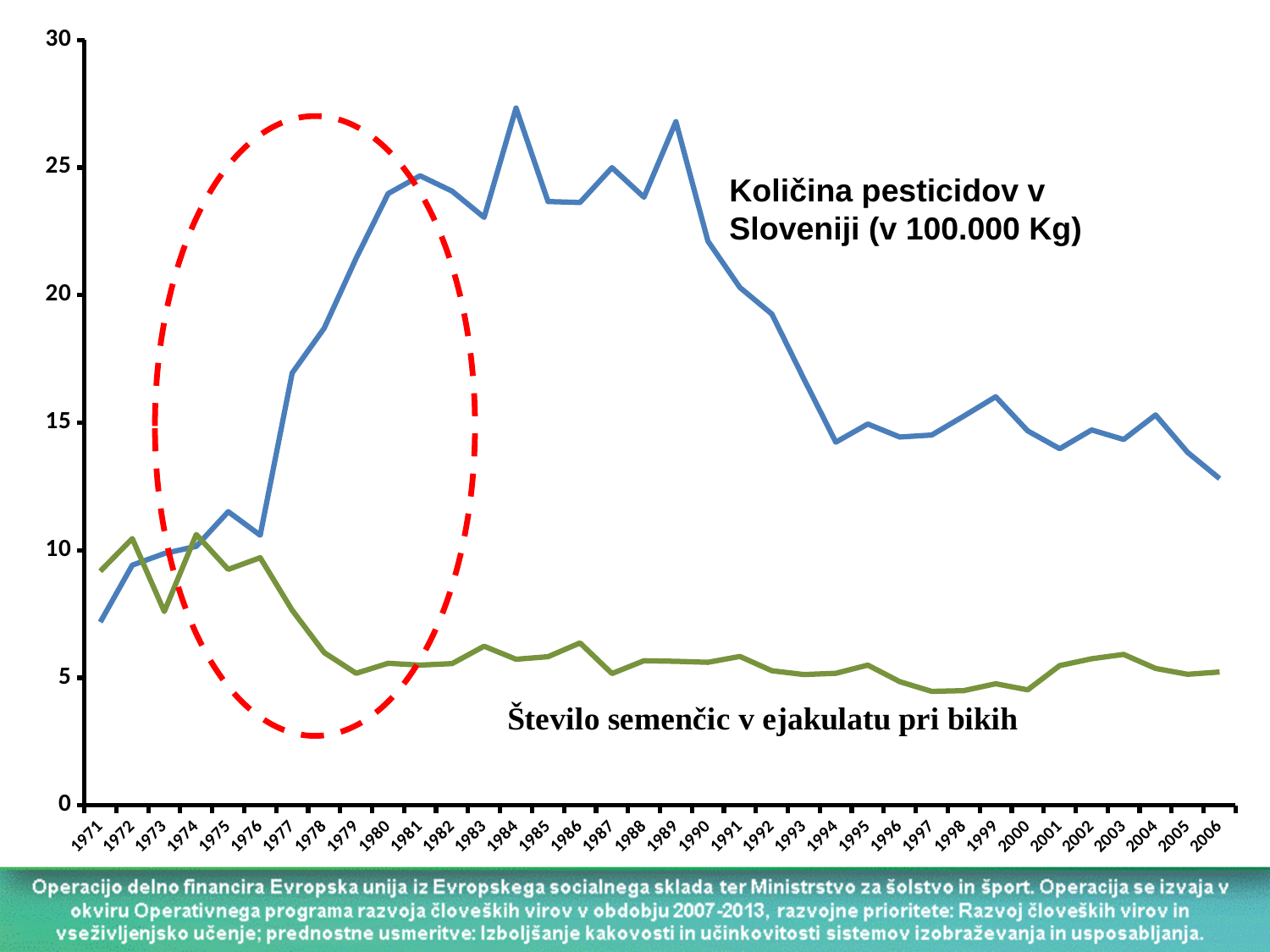
How many years are shown along the x axis of the chart? 36 What kind of chart is shown on the slide? line chart Is the value of the 'Količina pesticidov v Sloveniji' line in 1984 greater or less than 25? greater Is the value of the 'Število semenčic v ejakulatu pri bikih' line in 1986 greater or less than 5? greater Is the value of the 'Količina pesticidov v Sloveniji' line in 2006 greater or less than 15? less What is the first year shown on the x axis? 1971 Does the 'Količina pesticidov v Sloveniji' line rise or fall between 1989 and 1994? fall What colour is the line for 'Število semenčic v ejakulatu pri bikih'? green In 1990, which line has the higher value: 'Količina pesticidov v Sloveniji' or 'Število semenčic v ejakulatu pri bikih'? Količina pesticidov v Sloveniji In which year is the 'Količina pesticidov v Sloveniji' line at its lowest? 1971 What is the last year shown on the x axis? 2006